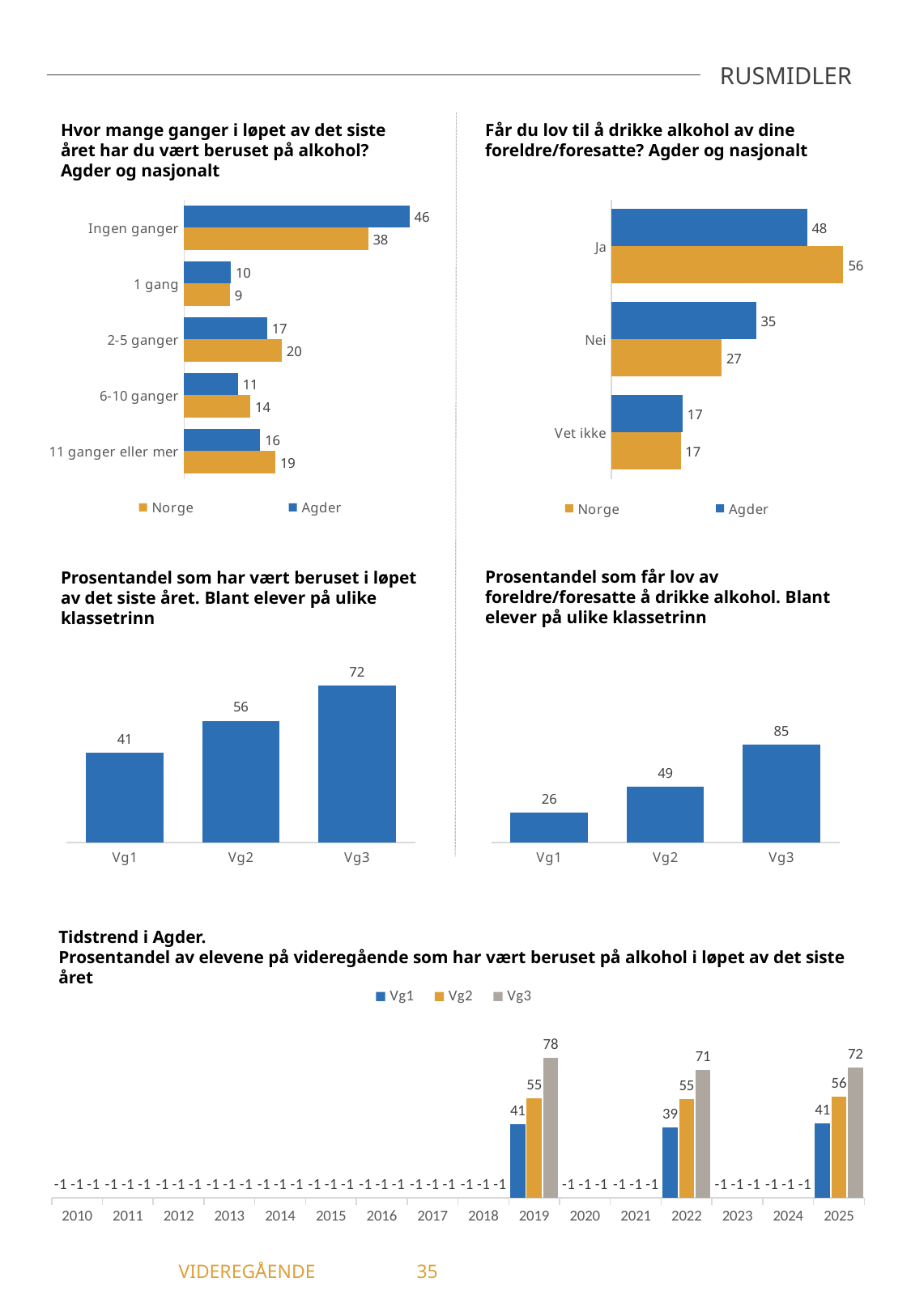
In the middle-right chart 'Prosentandel som får lov av foreldre/foresatte å drikke alkohol', what is the difference between Vg3 and Vg2? 36 In the bottom chart 'Tidstrend i Agder', what is the value for Vg3 in 2019? 78 In the top-left chart 'Hvor mange ganger i løpet av det siste året har du vært beruset på alkohol?', how many categories are shown? 5 In the top-right chart 'Får du lov til å drikke alkohol av dine foreldre/foresatte?', what is the value for Norge in the 'Ja' category? 56 In the middle-left chart 'Prosentandel som har vært beruset i løpet av det siste året', which klassetrinn has the highest value? Vg3 In the middle-right chart 'Prosentandel som får lov av foreldre/foresatte å drikke alkohol', what is the value for Vg1? 26 In the top-right chart 'Får du lov til å drikke alkohol av dine foreldre/foresatte?', which is larger for 'Nei': Agder or Norge? Agder In the top-left chart 'Hvor mange ganger i løpet av det siste året har du vært beruset på alkohol?', what is the difference between the Norge and Agder values for '2-5 ganger'? 3 In the top-left chart 'Hvor mange ganger i løpet av det siste året har du vært beruset på alkohol?', what is the value for Agder in the 'Ingen ganger' category? 46 In the top-right chart 'Får du lov til å drikke alkohol av dine foreldre/foresatte?', how many series does the legend list? 2 In the middle-left chart 'Prosentandel som har vært beruset i løpet av det siste året', do the values rise or fall from Vg1 to Vg3? rise What kind of chart is the bottom chart 'Tidstrend i Agder'? bar chart